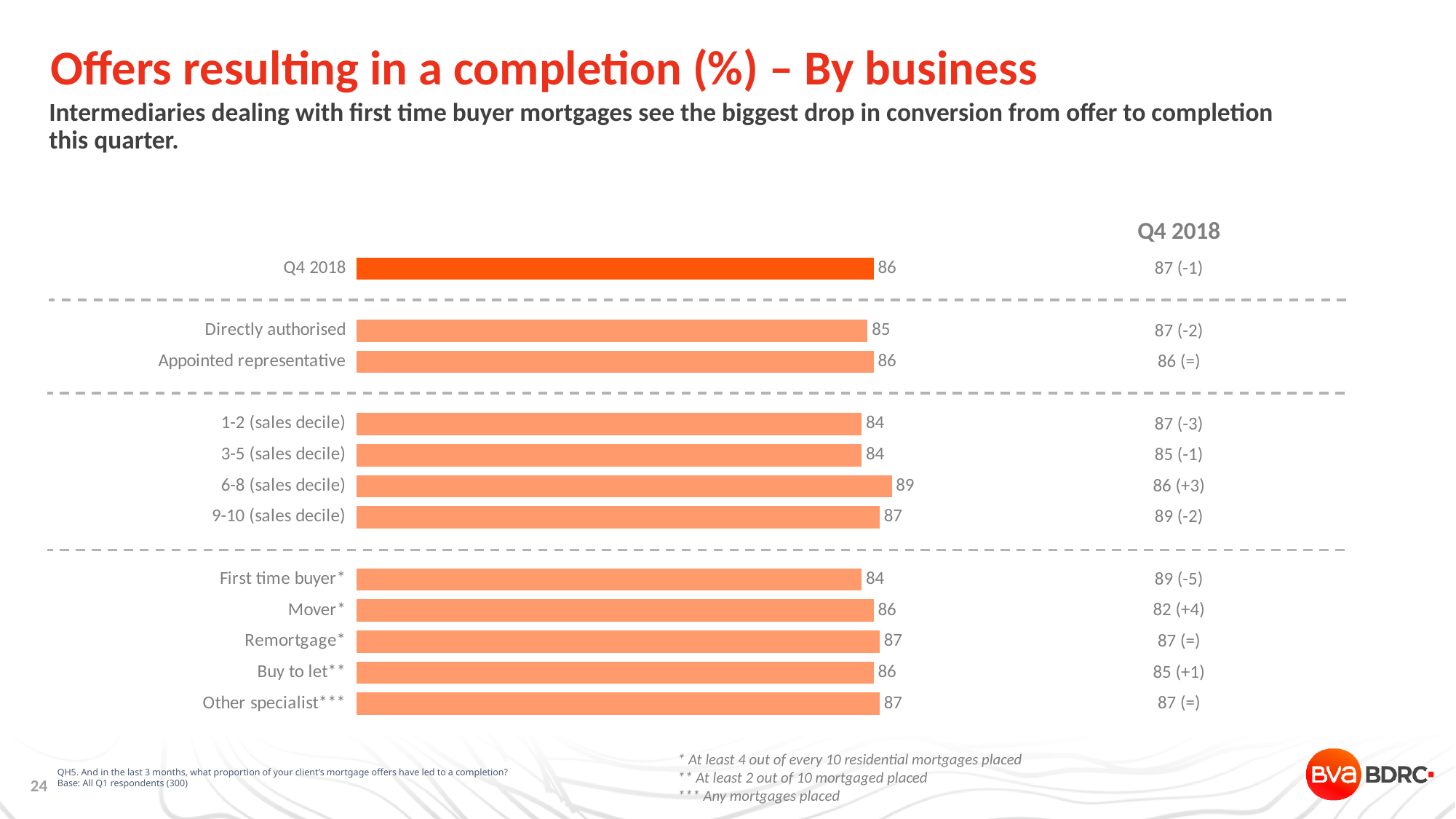
What is the difference between the values for Remortgage and First time buyer? 3 How many bars are plotted in the chart? 13 What is the difference between the values for 6-8 (sales decile) and 3-5 (sales decile)? 5 What is the value for Directly authorised? 85 What is the value for First time buyer? 84 What is the value for Remortgage? 87 What is the value for 6-8 (sales decile)? 89 Which is larger, the value for 9-10 (sales decile) or the value for 1-2 (sales decile)? 9-10 (sales decile) Which is larger, the value for Directly authorised or the value for Other specialist? Other specialist What kind of chart is shown on the slide? Bar chart Which category has the highest value? 6-8 (sales decile) What is the value for Buy to let? 86